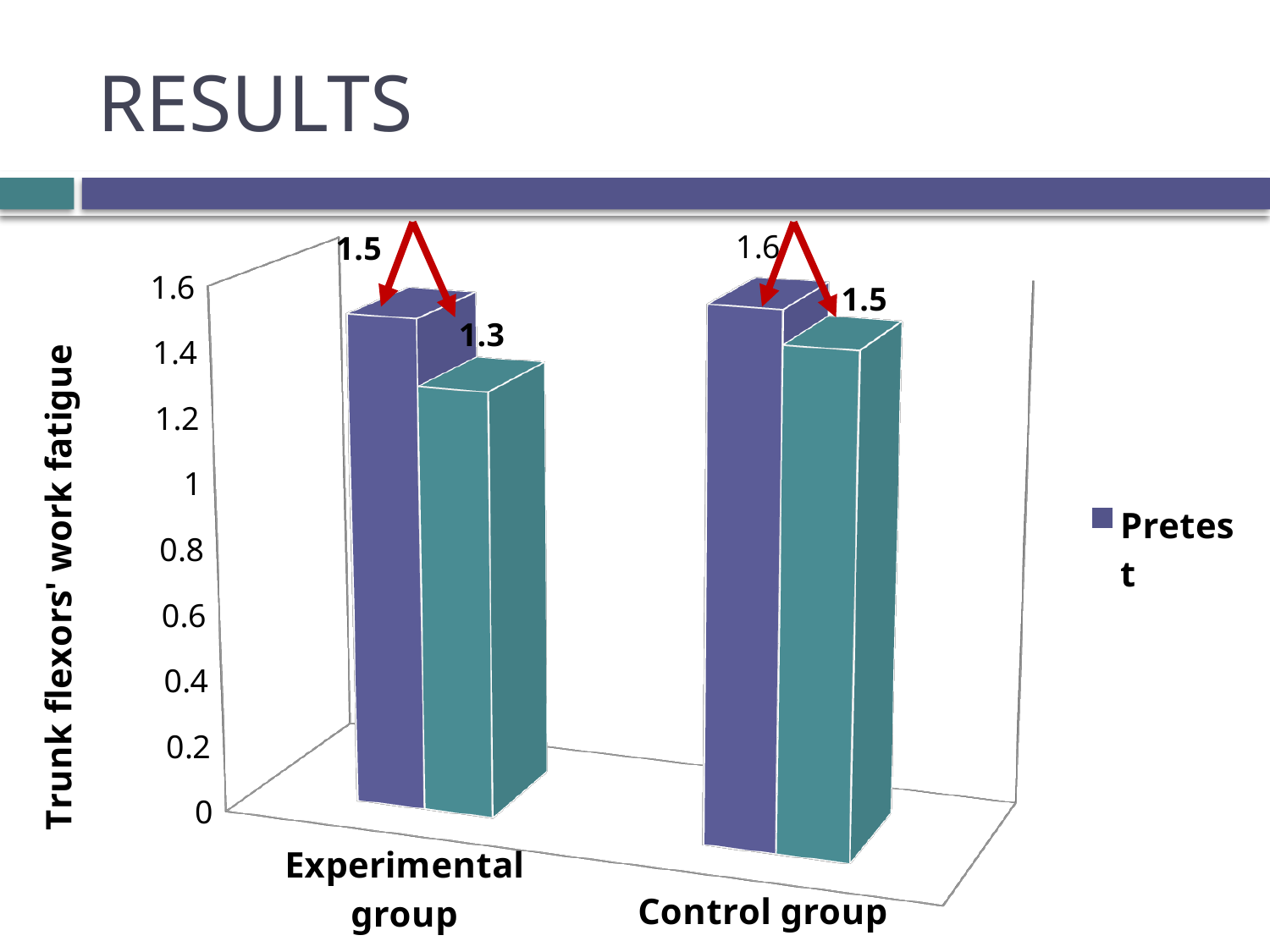
What is the Pretest value for the Experimental group? 1.5 What value is labelled on the teal bar for the Control group? 1.5 What is the lowest value labelled on the chart? 1.3 What is the difference between the Pretest value and the teal bar value for the Control group? 0.1 Which group has the highest Pretest value? Control group What kind of chart is shown on the slide? Bar chart What value is labelled on the teal bar for the Experimental group? 1.3 What is the difference between the Pretest value and the teal bar value for the Experimental group? 0.2 How many groups are shown on the x axis of the chart? 2 Which group has the higher Pretest value, the Experimental group or the Control group? Control group What is the label of the vertical axis of the chart? Trunk flexors' work fatigue What is the Pretest value for the Control group? 1.6